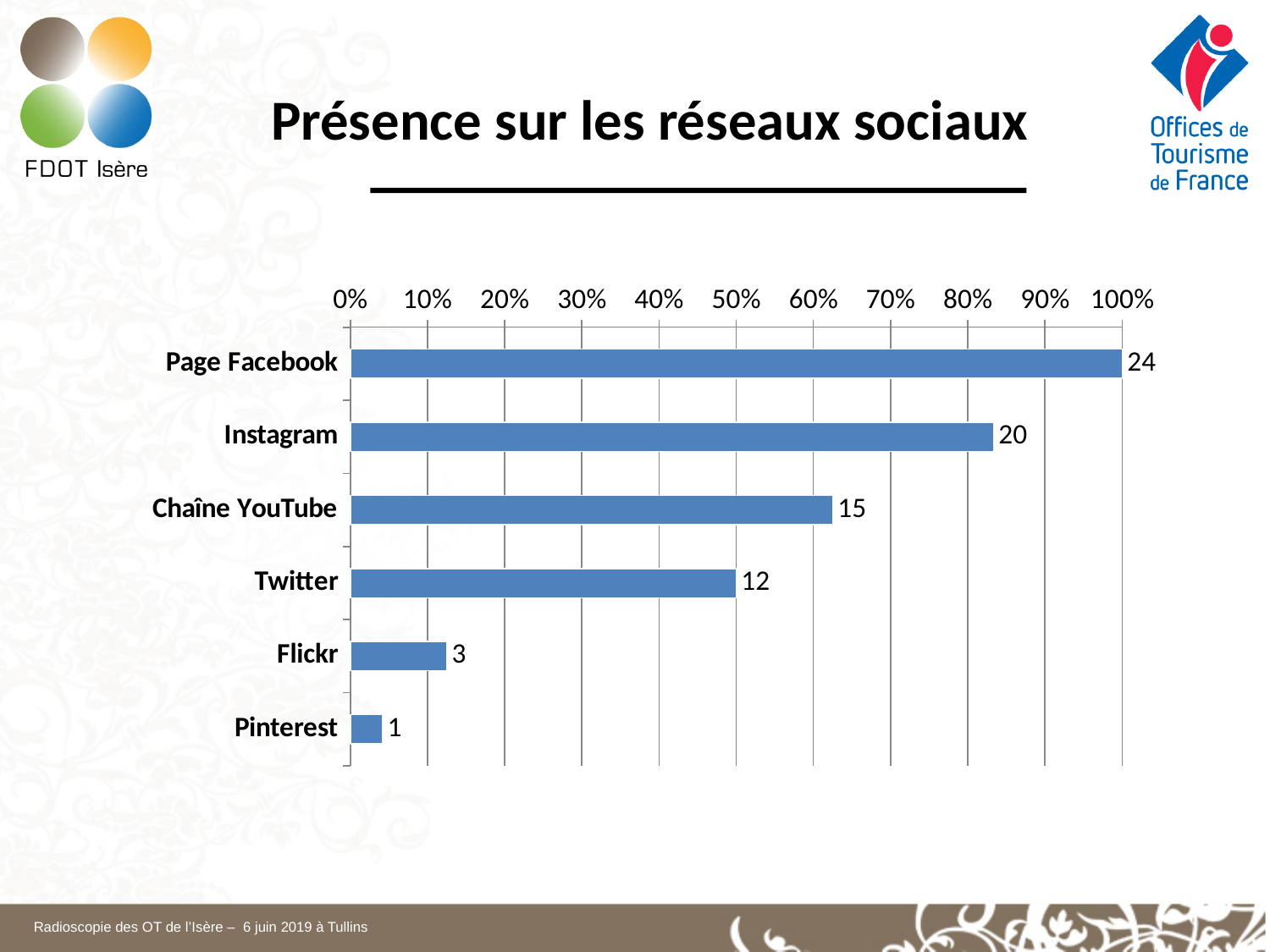
Which is larger, the value for Instagram or the value for Chaîne YouTube? Instagram What is the difference between the data labels for Page Facebook and Twitter? 12 What is the data label shown for Chaîne YouTube? 15 How many categories are shown in the chart? 6 What is the data label shown for Instagram? 20 What is the data label shown for Flickr? 3 Is the bar for Pinterest greater or less than 10% on the axis? less What type of chart is shown on the slide? Bar chart Which category has the highest value? Page Facebook What is the data label shown for Page Facebook? 24 Is the bar for Instagram greater or less than 80% on the axis? greater Which category has the lowest value? Pinterest